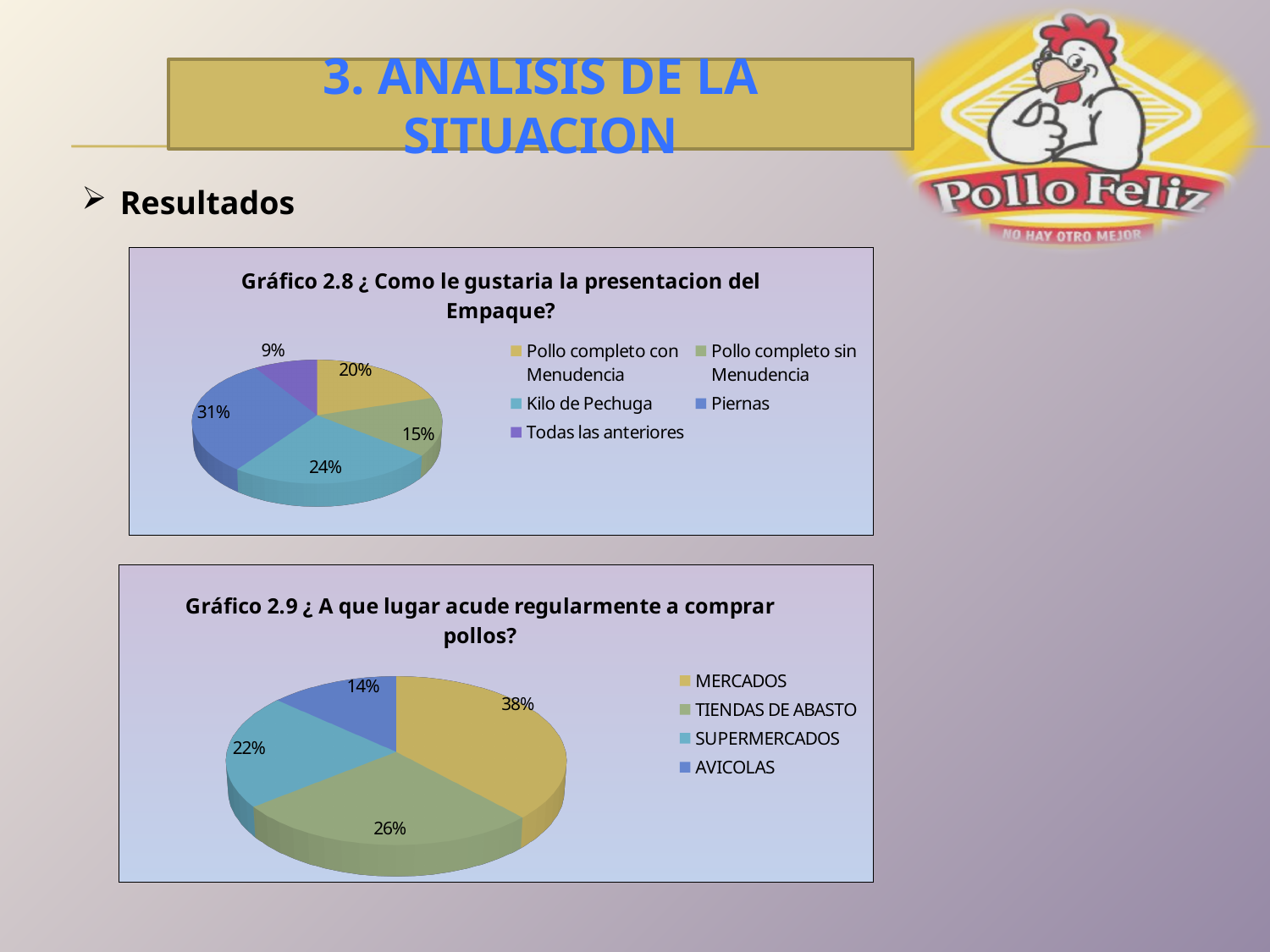
In Gráfico 2.8, what percentage is shown for Kilo de Pechuga? 24% In Gráfico 2.8, what percentage is shown for Piernas? 31% In Gráfico 2.9, what percentage is shown for MERCADOS? 38% In Gráfico 2.8, how many categories does the legend list? 5 In Gráfico 2.8, which category has the smallest share? Todas las anteriores In Gráfico 2.9, which is larger, TIENDAS DE ABASTO or SUPERMERCADOS? TIENDAS DE ABASTO What type of chart is Gráfico 2.9? Pie chart In Gráfico 2.9, what percentage is shown for AVICOLAS? 14% In Gráfico 2.9, what is the difference between the shares for MERCADOS and AVICOLAS? 24% In Gráfico 2.8, what is the difference between the shares for Pollo completo con Menudencia and Pollo completo sin Menudencia? 5% In Gráfico 2.8, what percentage is shown for Todas las anteriores? 9% In Gráfico 2.8, which category has the largest share? Piernas